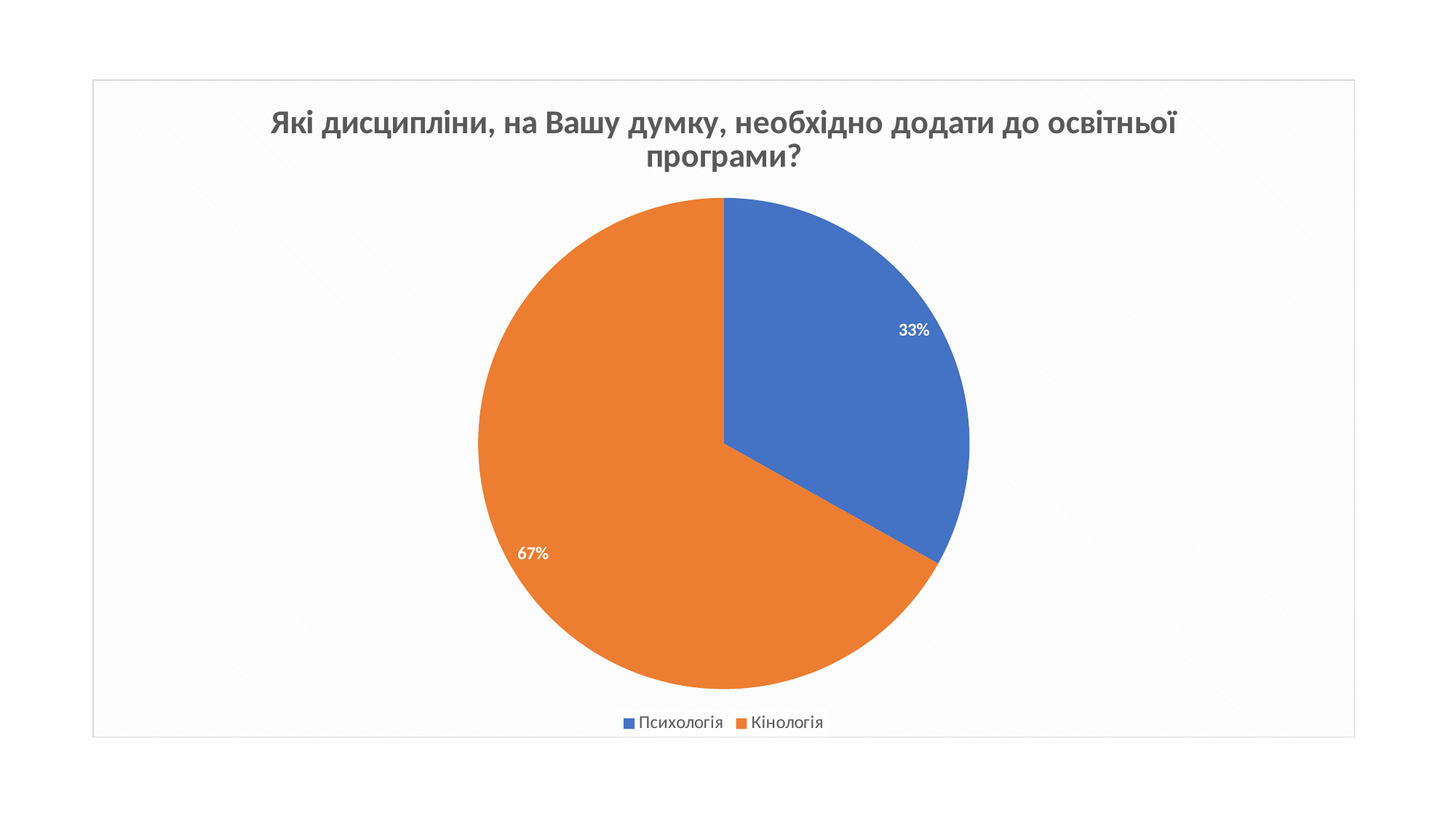
What is the difference in percentage points between the Кінологія slice and the Психологія slice? 34 percentage points Which category has the largest slice of the pie? Кінологія What colour is the slice for Кінологія? orange Which is larger, the slice for Психологія or the slice for Кінологія? Кінологія How many categories does the pie chart show? 2 How many entries does the legend list? 2 What kind of chart is shown on the slide? pie chart Which category has the smallest slice of the pie? Психологія What share of the pie does Кінологія have? 67% What share of the pie does Психологія have? 33% What is the title of the chart? Які дисципліни, на Вашу думку, необхідно додати до освітньої програми?